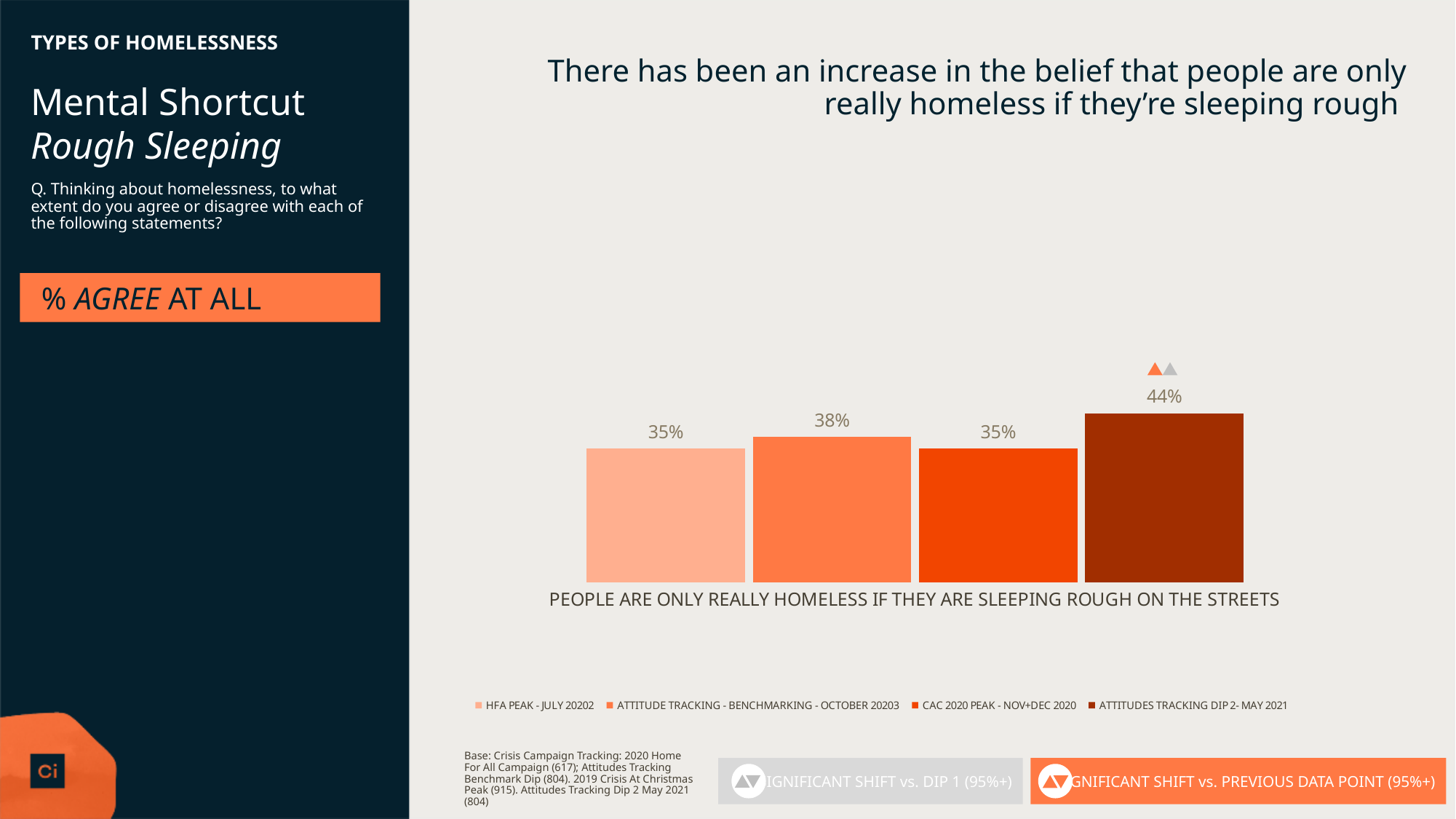
Which is larger, the value for ATTITUDE TRACKING - BENCHMARKING - OCTOBER 20203 or the value for CAC 2020 PEAK - NOV+DEC 2020? ATTITUDE TRACKING - BENCHMARKING - OCTOBER 20203 What kind of chart is shown on the slide? Bar chart What is the value for the CAC 2020 PEAK - NOV+DEC 2020 series? 35% What is the value for the ATTITUDES TRACKING DIP 2- MAY 2021 series? 44% How many series does the legend list? 4 Which series has the highest value? ATTITUDES TRACKING DIP 2- MAY 2021 What is the difference between the ATTITUDES TRACKING DIP 2- MAY 2021 value and the CAC 2020 PEAK - NOV+DEC 2020 value? 9% What is the value for the ATTITUDE TRACKING - BENCHMARKING - OCTOBER 20203 series? 38% What is the category label shown beneath the bars? PEOPLE ARE ONLY REALLY HOMELESS IF THEY ARE SLEEPING ROUGH ON THE STREETS What is the value for the HFA PEAK - JULY 20202 series? 35% What is the difference between the ATTITUDE TRACKING - BENCHMARKING - OCTOBER 20203 value and the HFA PEAK - JULY 20202 value? 3% What measure does the chart show, according to the orange box on the left? % AGREE AT ALL